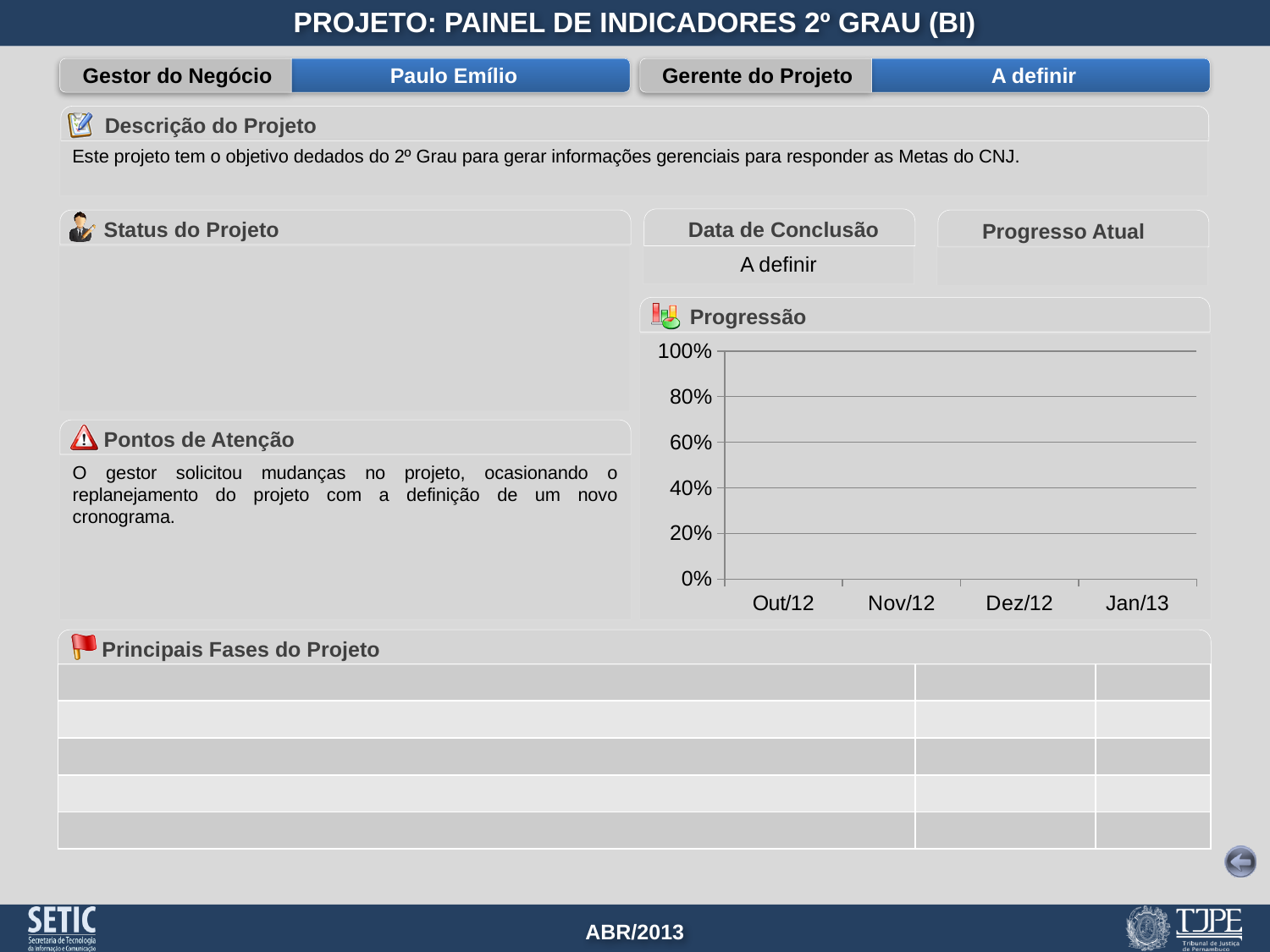
What is the highest value shown on the y axis of the Progressão chart? 100% What is the last category on the x axis of the Progressão chart? Jan/13 What is the title of the chart on the slide? Progressão What is the first category on the x axis of the Progressão chart? Out/12 How many categories are shown on the x axis of the Progressão chart? 4